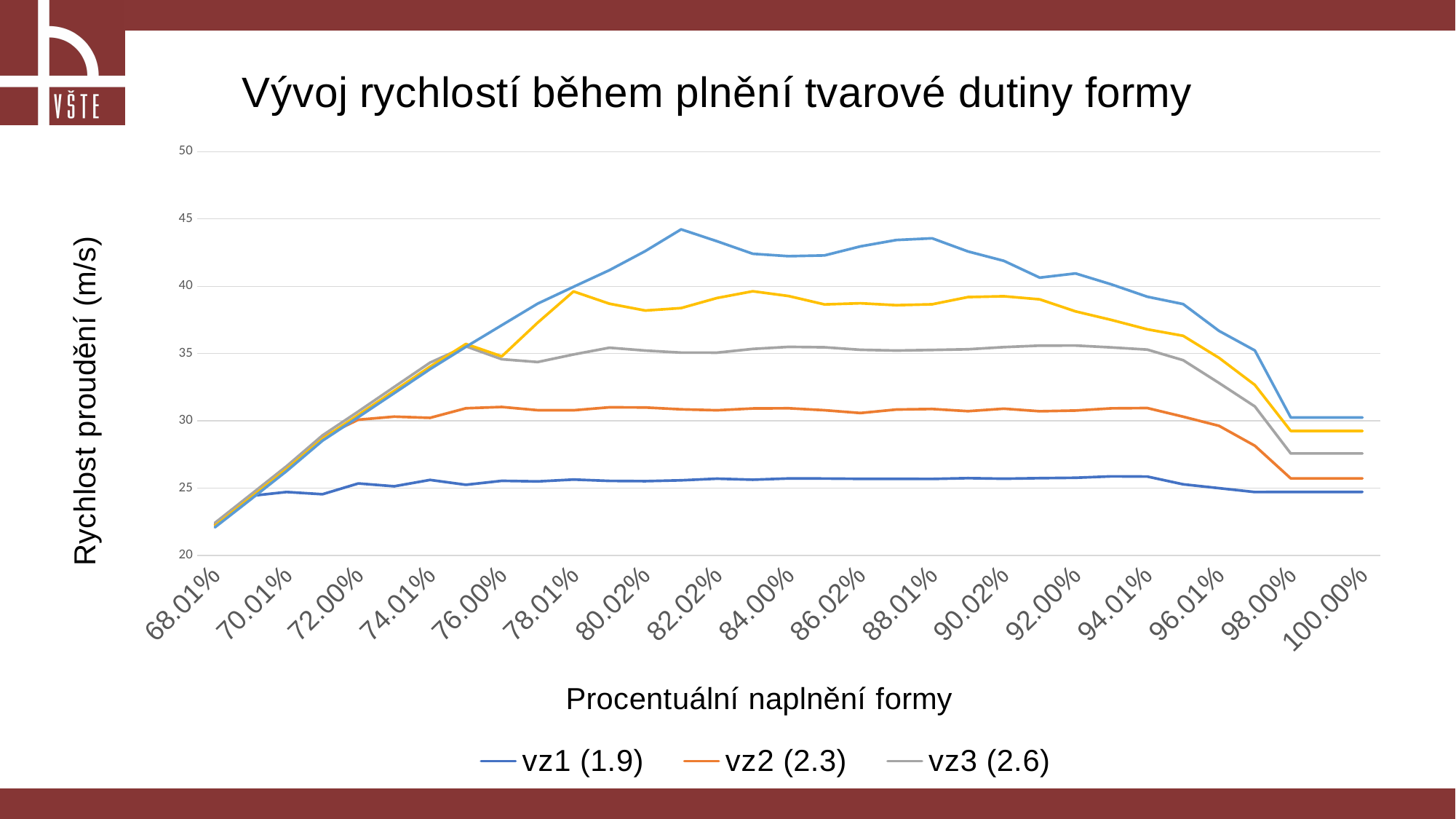
Is the value for vz1 (1.9) at 68.01% greater or less than 25? less Is the value for vz2 (2.3) at 84.00% greater or less than 35? less Does the value for vz3 (2.6) rise or fall between 94.01% and 100.00%? fall Among the series listed in the legend, which has the lowest value at 84.00%? vz1 (1.9) Is the value for vz3 (2.6) at 84.00% greater or less than 30? greater What kind of chart is shown on the slide? line chart What is the label of the vertical axis? Rychlost proudění (m/s) What is the title of the chart? Vývoj rychlostí během plnění tvarové dutiny formy At 100.00%, which is higher: vz3 (2.6) or vz2 (2.3)? vz3 (2.6) How many series does the legend list? 3